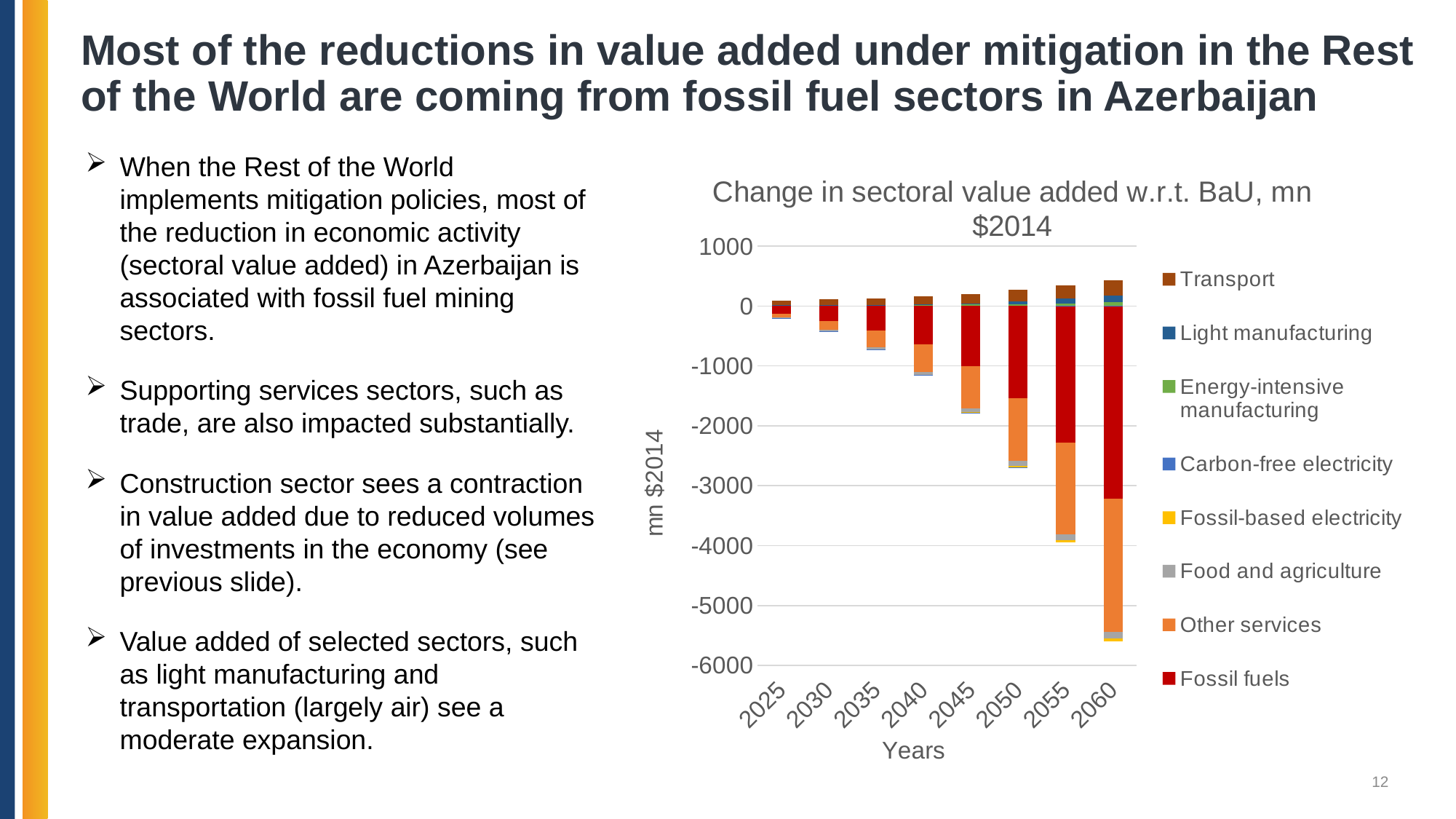
How many series does the chart legend list? 8 Which year has the largest total negative change in sectoral value added? 2060 How many years are shown on the x axis of the chart? 8 Is the bottom of the stacked bar for 2055 greater or less than -3000? less What kind of chart is shown on the slide? Stacked bar chart What is the title of the chart? Change in sectoral value added w.r.t. BaU, mn $2014 Is the bottom of the stacked bar for 2025 greater or less than -1000? greater In 2060, which series has the larger negative contribution: Fossil fuels or Other services? Fossil fuels Which year has the smallest total negative change in sectoral value added? 2025 Is the bottom of the stacked bar for 2060 greater or less than -5000? less What is the label of the y axis of the chart? mn $2014 Do the negative totals of the stacked bars grow larger or smaller in magnitude from 2025 to 2060? Larger